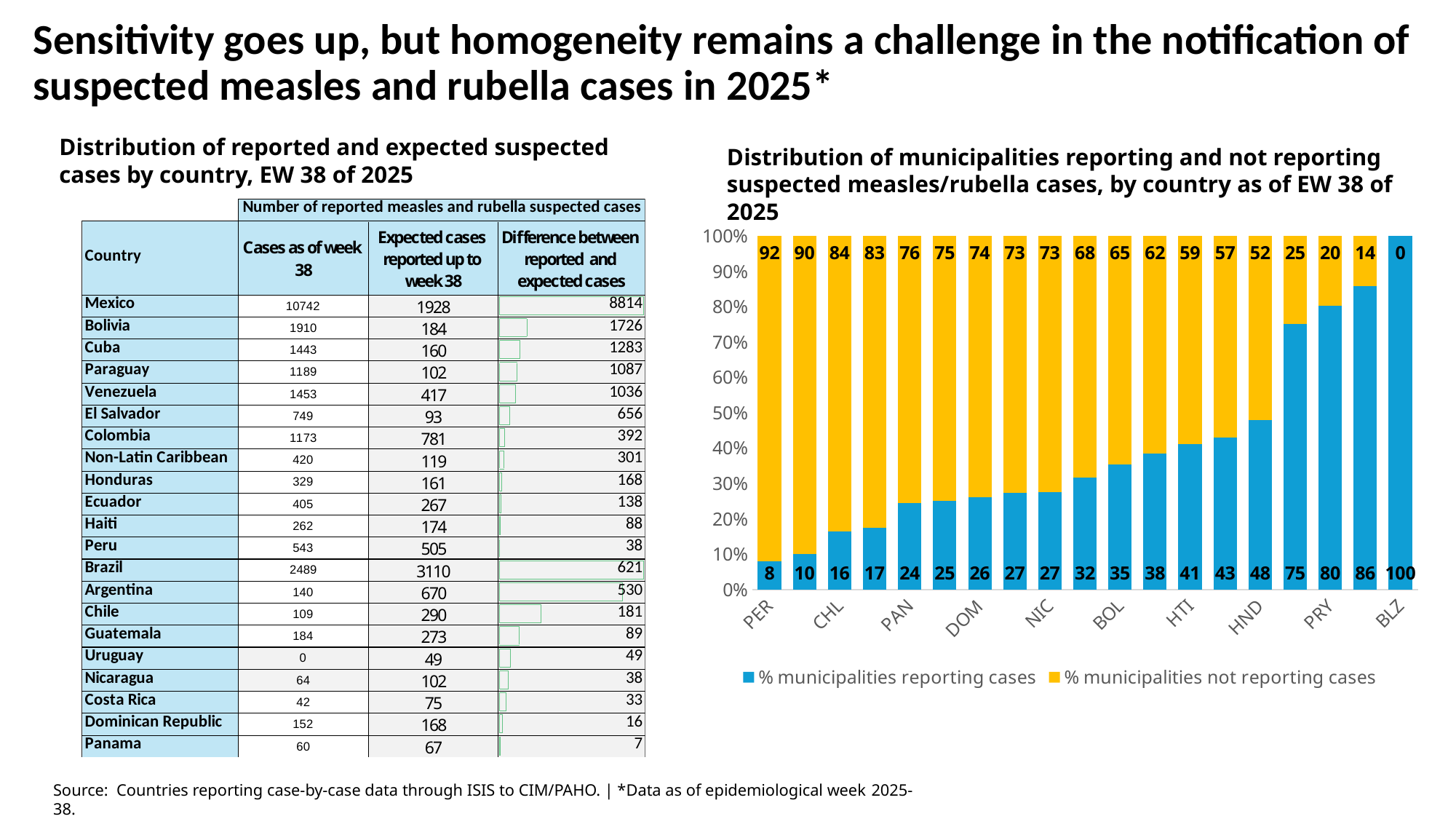
On the municipalities chart, what is the value for % municipalities reporting cases for HND? 48 On the municipalities chart, how many bars are plotted? 19 On the municipalities chart, how many series does the legend list? 2 On the municipalities chart, which has a larger % of municipalities reporting cases, PRY or BOL? PRY On the municipalities chart, what is the difference between the % municipalities reporting cases for HND and for PER? 40 On the municipalities chart, which labelled country has the lowest % of municipalities reporting cases? PER On the municipalities chart, what is the value for % municipalities reporting cases for PER? 8 On the municipalities chart, what is the value for % municipalities not reporting cases for CHL? 84 On the chart 'Distribution of municipalities reporting and not reporting suspected measles/rubella cases', what kind of chart is it? Stacked bar chart On the municipalities chart, what is the value for % municipalities not reporting cases for BLZ? 0 On the municipalities chart, does the % of municipalities reporting cases rise or fall from left to right along the x axis? Rise On the municipalities chart, which labelled country has the highest % of municipalities reporting cases? BLZ